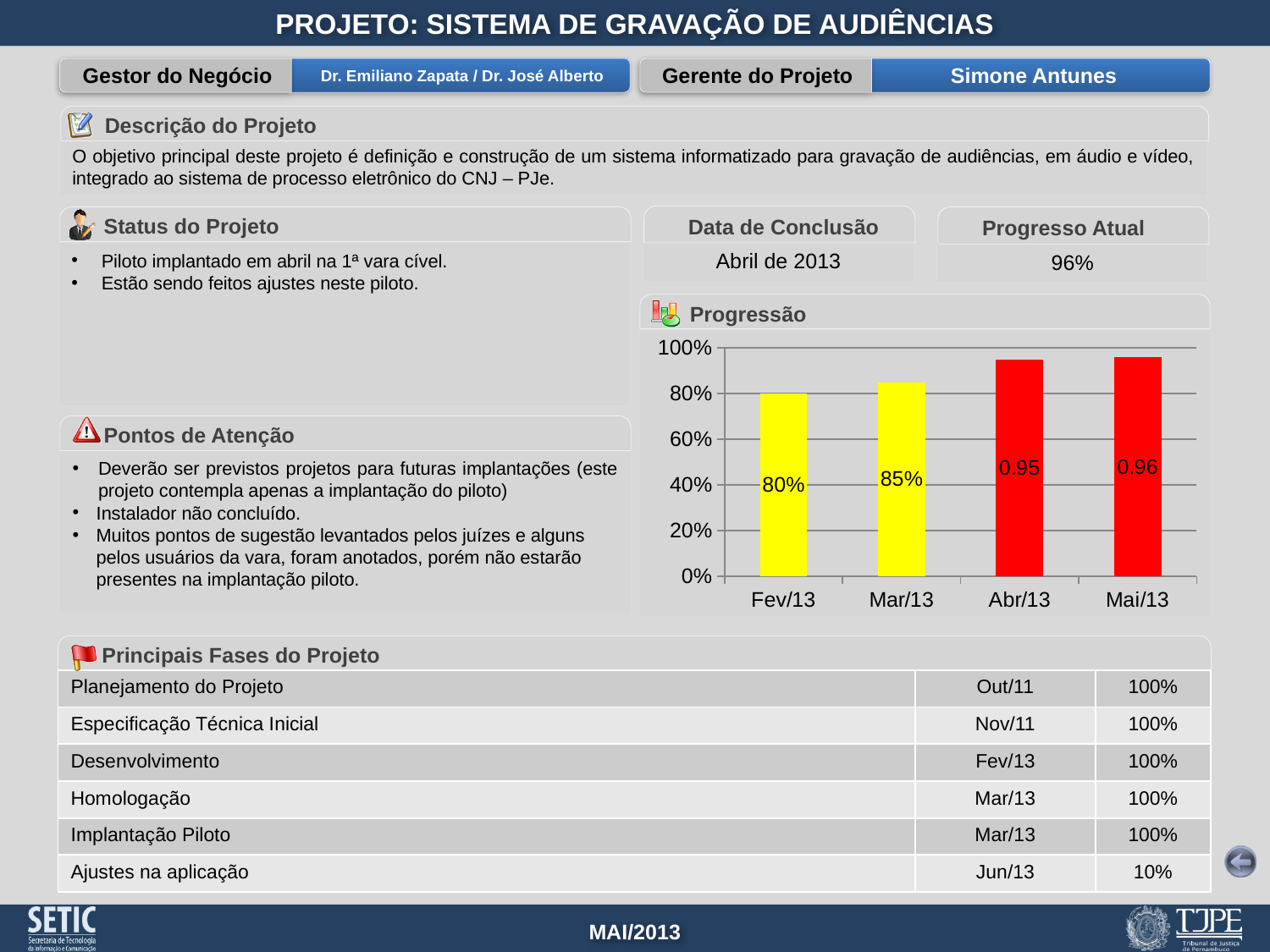
Is the value for Mar/13 in the Progressão chart greater or less than 60%? greater How many months are shown on the x axis of the Progressão chart? 4 What data label is printed on the Abr/13 bar in the Progressão chart? 0.95 Do the values in the Progressão chart rise or fall from Fev/13 to Mai/13? Rise By how much does the Mar/13 value exceed the Fev/13 value in the Progressão chart? 5% What kind of chart is the Progressão chart? Bar chart What is the value shown for Mar/13 in the Progressão chart? 85% Which is larger in the Progressão chart, the bar for Fev/13 or the bar for Abr/13? Abr/13 Which month has the highest bar in the Progressão chart? Mai/13 What data label is printed on the Mai/13 bar in the Progressão chart? 0.96 Which month has the lowest bar in the Progressão chart? Fev/13 What is the value shown for Fev/13 in the Progressão chart? 80%